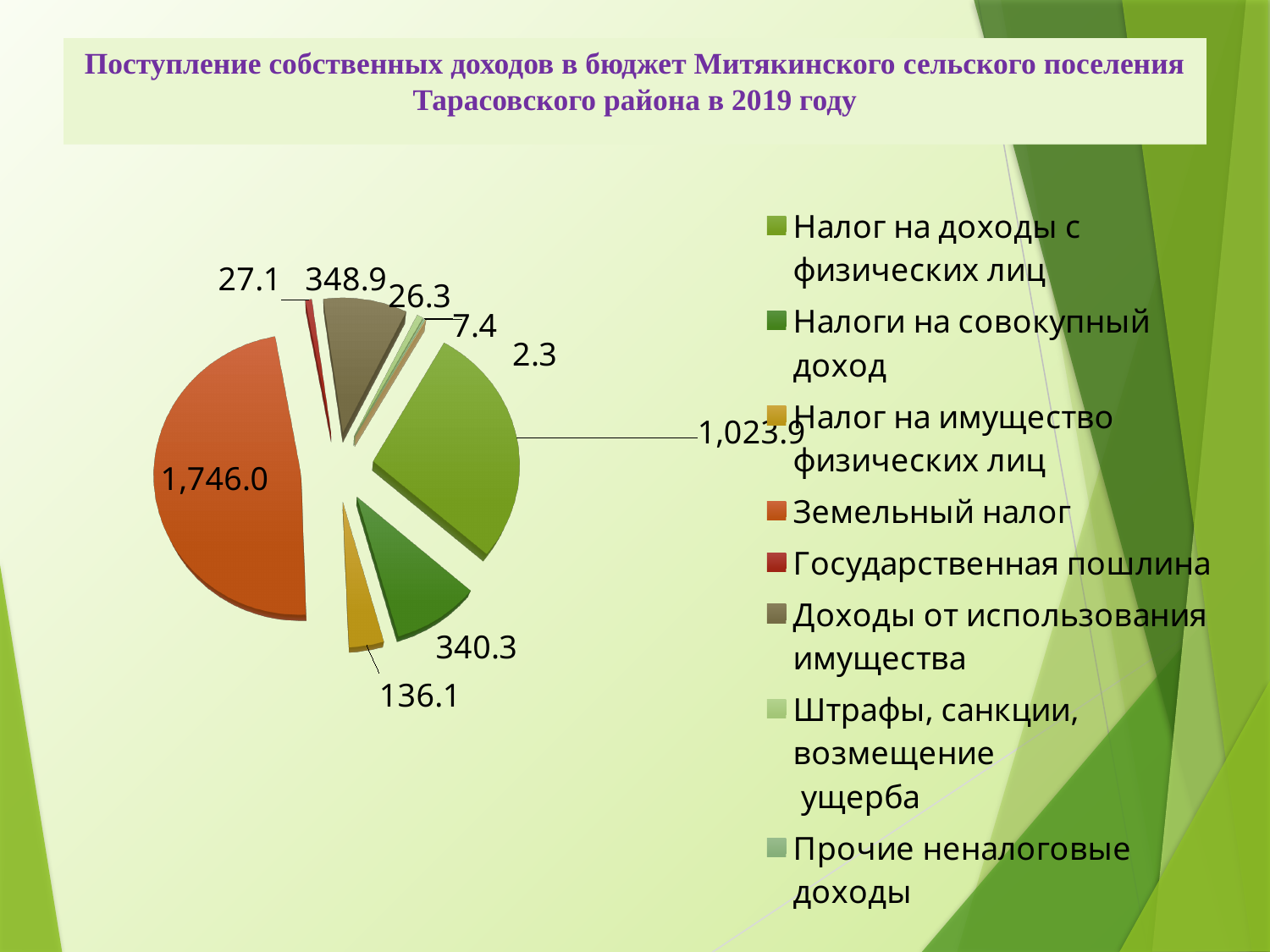
What is the value for Налоги на совокупный доход? 340.3 What is the difference between the values for Земельный налог and Налог на доходы с физических лиц? 722.1 How many entries does the legend list? 8 Which is larger, Земельный налог or Налог на доходы с физических лиц? Земельный налог What type of chart is shown on the slide? pie chart What is the value for Налог на доходы с физических лиц? 1,023.9 Which category has the largest slice of the pie? Земельный налог What is the value for Земельный налог? 1,746.0 What is the value for Налог на имущество физических лиц? 136.1 What is the difference between the values for Налоги на совокупный доход and Налог на имущество физических лиц? 204.2 What is the value for Доходы от использования имущества? 348.9 What is the value for Государственная пошлина? 27.1